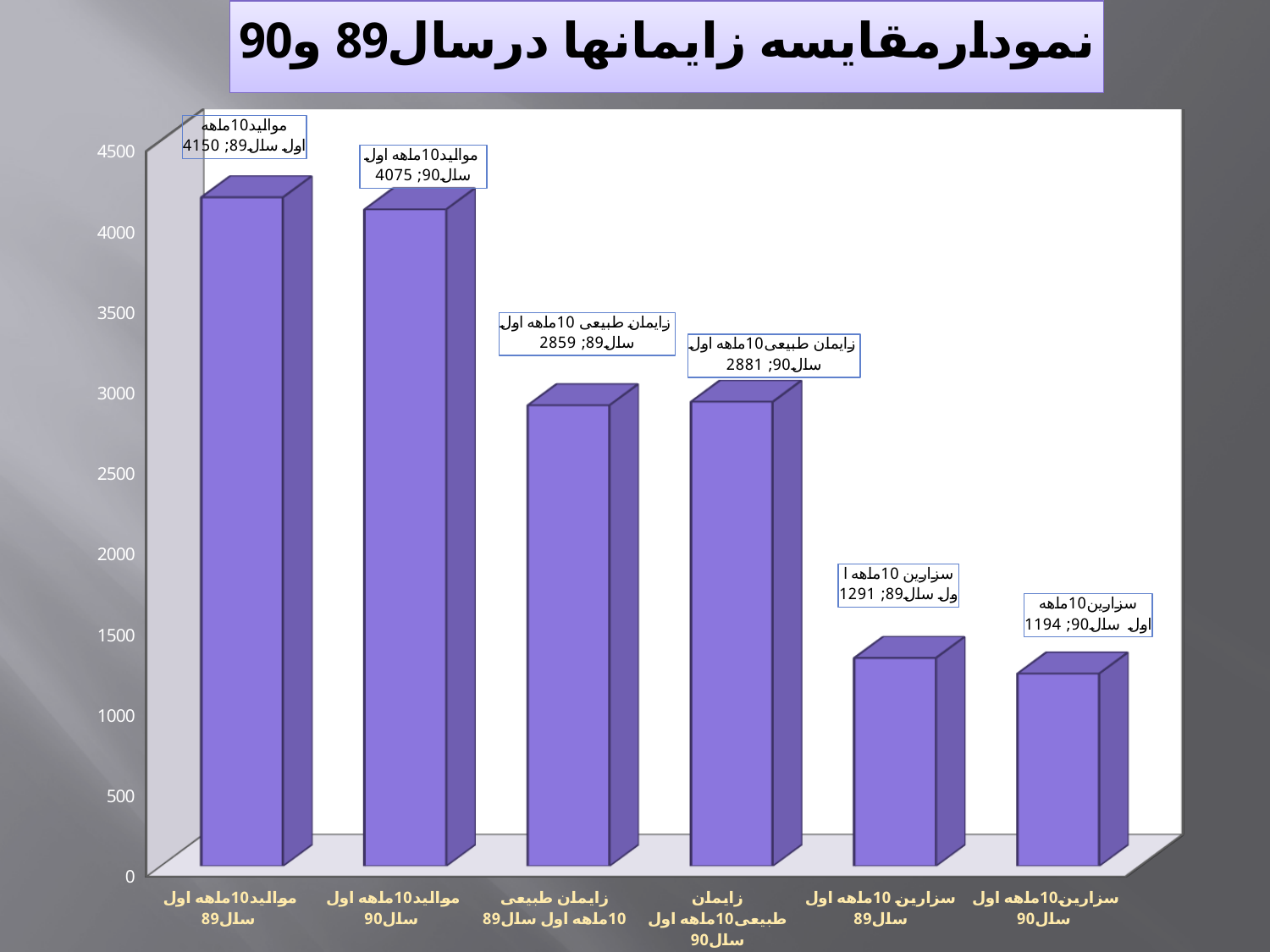
Which is larger: زایمان طبیعی 10 ماهه اول سال 89 or زایمان طبیعی 10 ماهه اول سال 90? زایمان طبیعی 10 ماهه اول سال 90 What is the difference between موالید 10 ماهه اول سال 89 and موالید 10 ماهه اول سال 90? 75 What is the title of the chart on the slide? نمودارمقایسه زایمانها درسال89 و90 What is the value for زایمان طبیعی 10 ماهه اول سال 89? 2859 What kind of chart is shown on the slide? bar chart What is the value for موالید 10 ماهه اول سال 90? 4075 What is the value for موالید 10 ماهه اول سال 89? 4150 Which category has the highest value? موالید 10 ماهه اول سال 89 How many bars are shown in the chart? 6 What is the value for سزارین 10 ماهه اول سال 90? 1194 Which category has the lowest value? سزارین 10 ماهه اول سال 90 What is the difference between سزارین 10 ماهه اول سال 89 and سزارین 10 ماهه اول سال 90? 97